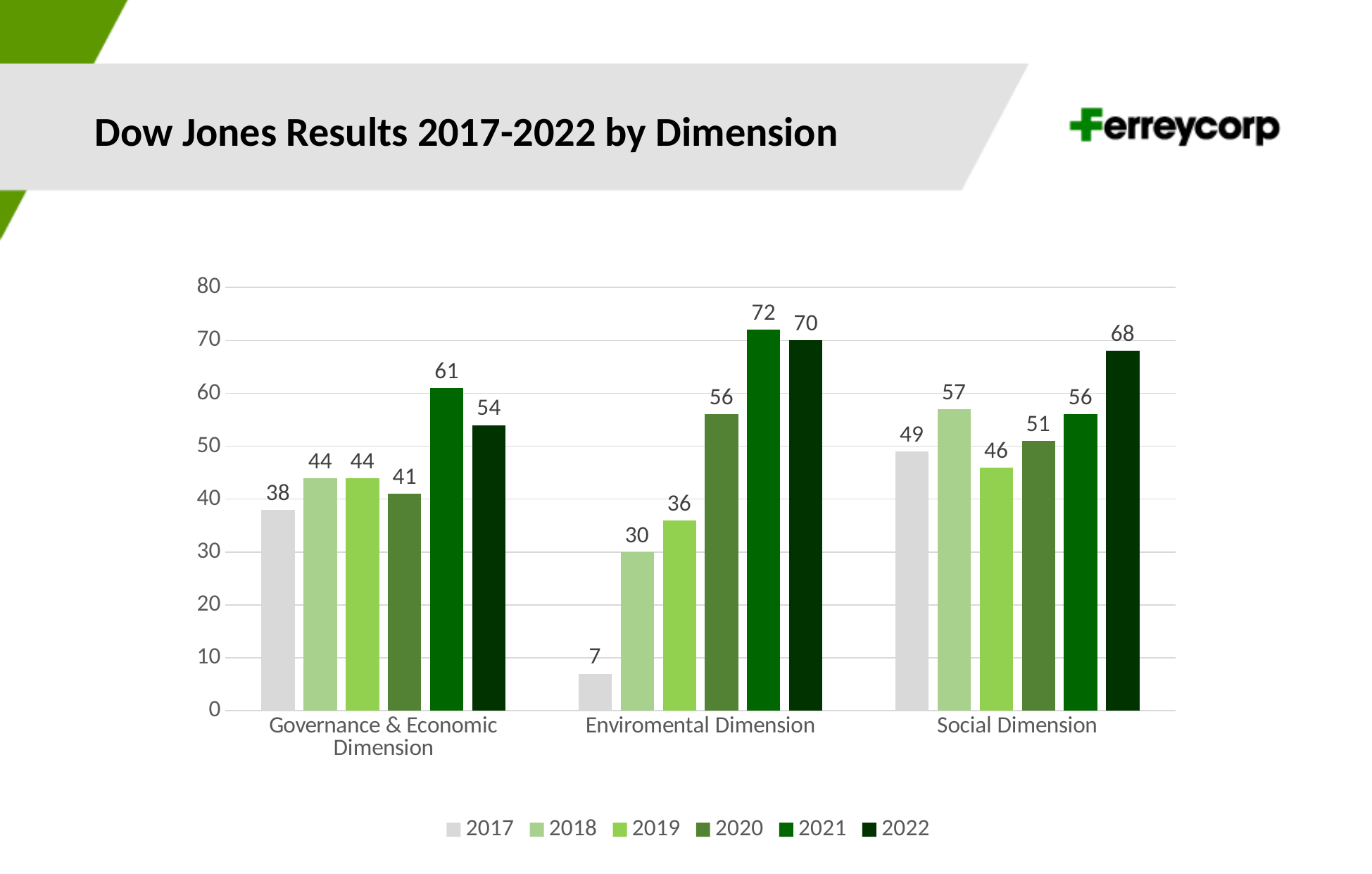
Which is larger in the Governance & Economic Dimension: the 2021 value or the 2022 value? 2021 What kind of chart is shown on the slide? Bar chart What is the difference between the 2018 and 2019 values in the Social Dimension? 11 Which year has the highest value in the Social Dimension? 2022 What is the value for 2017 in the Governance & Economic Dimension? 38 What is the value for 2021 in the Enviromental Dimension? 72 What is the value for 2022 in the Social Dimension? 68 Which year has the lowest value in the Enviromental Dimension? 2017 What is the title of the chart? Dow Jones Results 2017-2022 by Dimension What is the difference between the 2021 and 2017 values in the Enviromental Dimension? 65 How many dimensions (categories) are shown on the x axis? 3 How many series does the legend list? 6